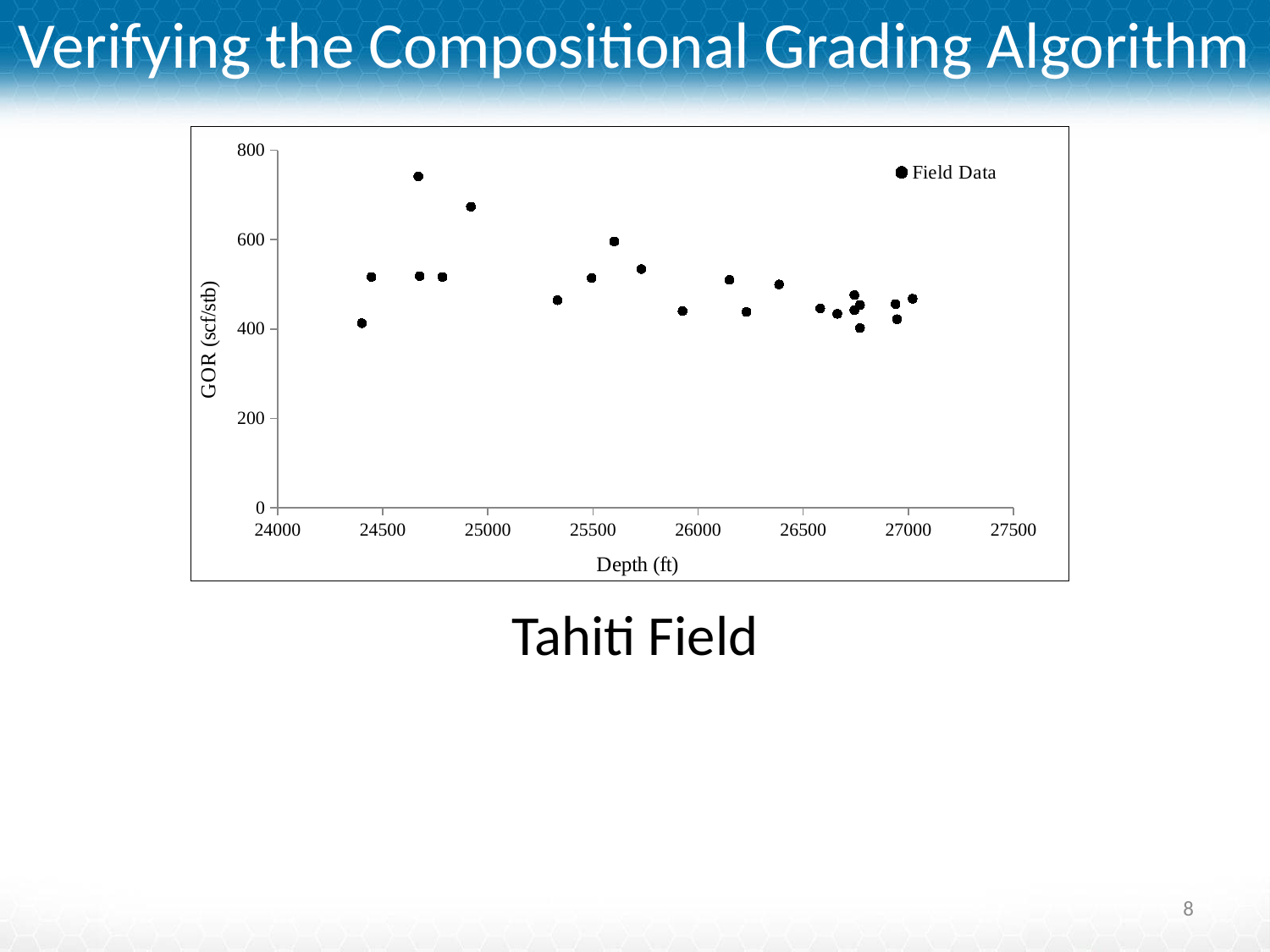
Is the highest GOR value plotted greater or less than 800? less Is the GOR value of the point near 24900 ft greater or less than 600? greater Overall, do the GOR values rise or fall as depth increases along the x axis? fall Is the GOR value of the deepest data point (near 27000 ft) greater or less than 200? greater How many series does the chart legend list? 1 What are the x-axis and y-axis titles of the chart? Depth (ft) and GOR (scf/stb) What is the name of the series shown in the chart legend? Field Data What kind of chart is shown on the slide? scatter chart